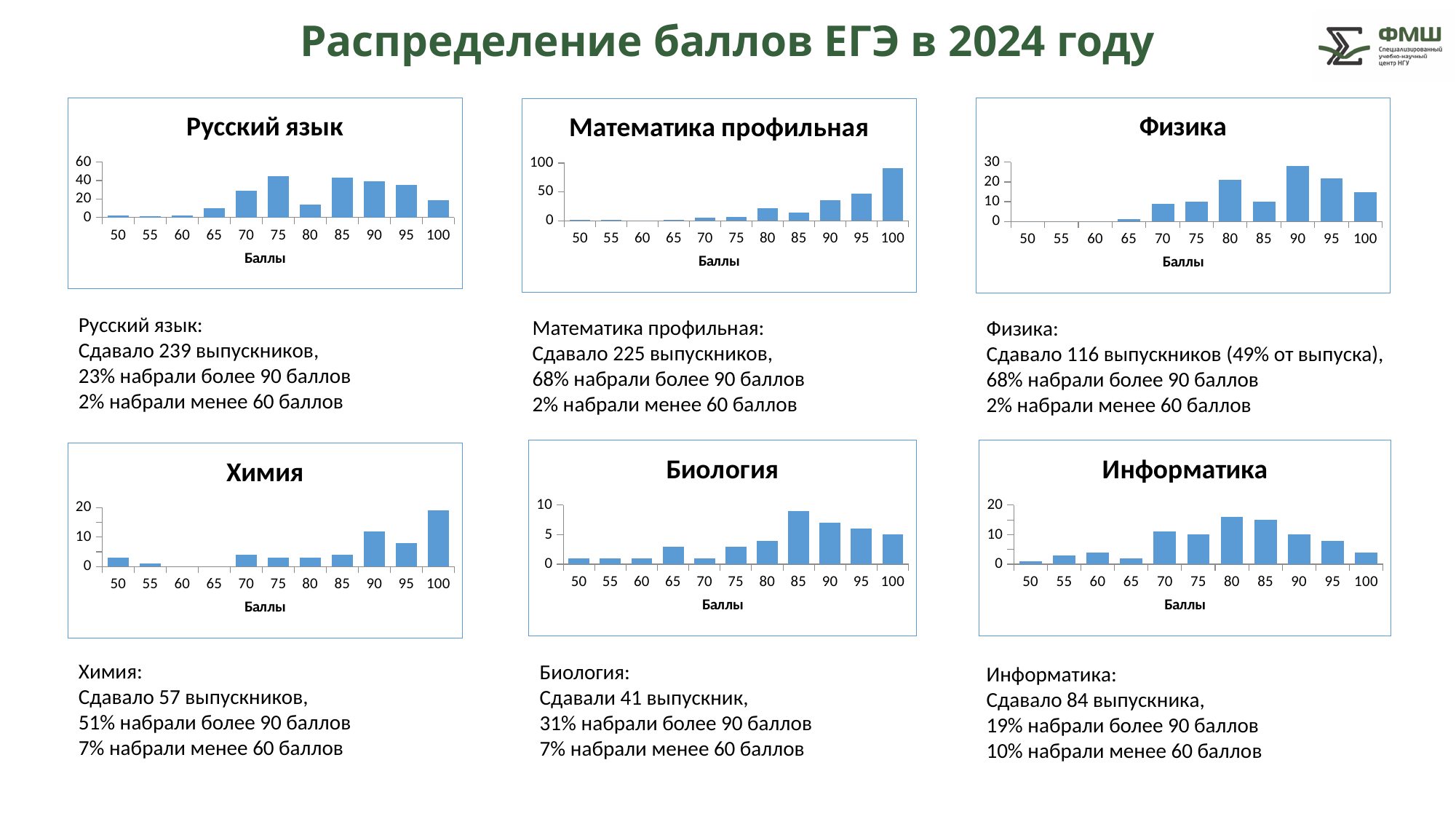
How many score categories are shown on the x axis of the "Химия" chart? 11 In the "Русский язык" chart, is the value for 75 greater or less than 40? greater In the "Математика профильная" chart, is the value for 100 greater or less than 50? greater What is the x-axis title of the "Информатика" chart? Баллы In the "Физика" chart, is the value for 90 greater or less than 20? greater In the "Биология" chart, which score category has the highest bar? 85 In the "Химия" chart, which is larger, the value for 90 or the value for 95? 90 What kind of chart is the "Русский язык" chart? bar chart In the "Математика профильная" chart, which score category has the highest bar? 100 In the "Физика" chart, which is larger, the value for 80 or the value for 85? 80 In the "Химия" chart, which score category has the highest bar? 100